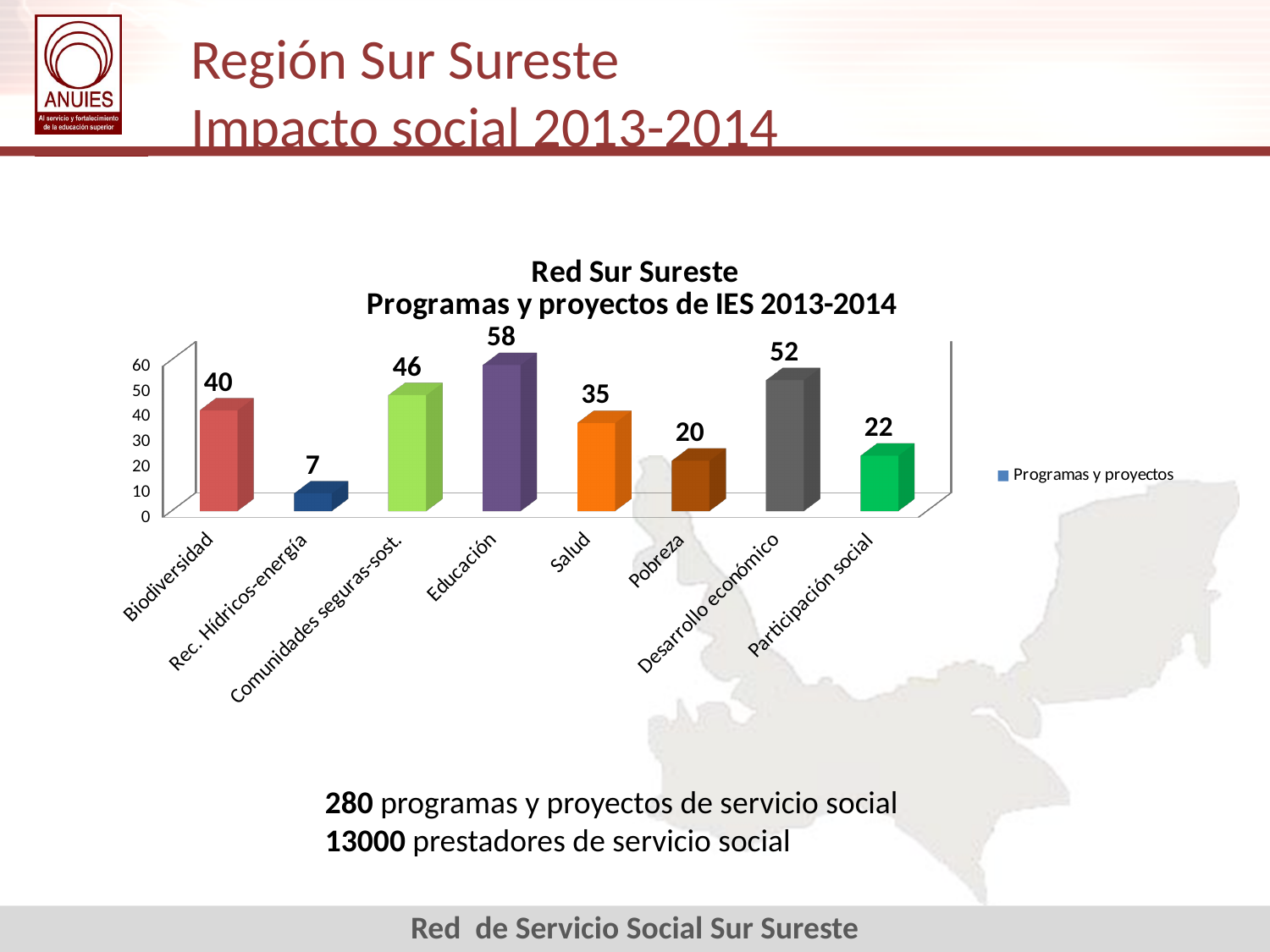
What kind of chart is shown? bar chart What is the title of the chart? Red Sur Sureste Programas y proyectos de IES 2013-2014 What is the value for Educación? 58 What is the value for Desarrollo económico? 52 Which is larger, the value for Biodiversidad or the value for Participación social? Biodiversidad How many series does the legend list? 1 How many categories are shown on the x axis? 8 Which category has the highest value? Educación Which category has the lowest value? Rec. Hídricos-energía What is the difference between the values for Educación and Salud? 23 What is the value for Rec. Hídricos-energía? 7 Is the value for Comunidades seguras-sost. greater or less than 40? greater